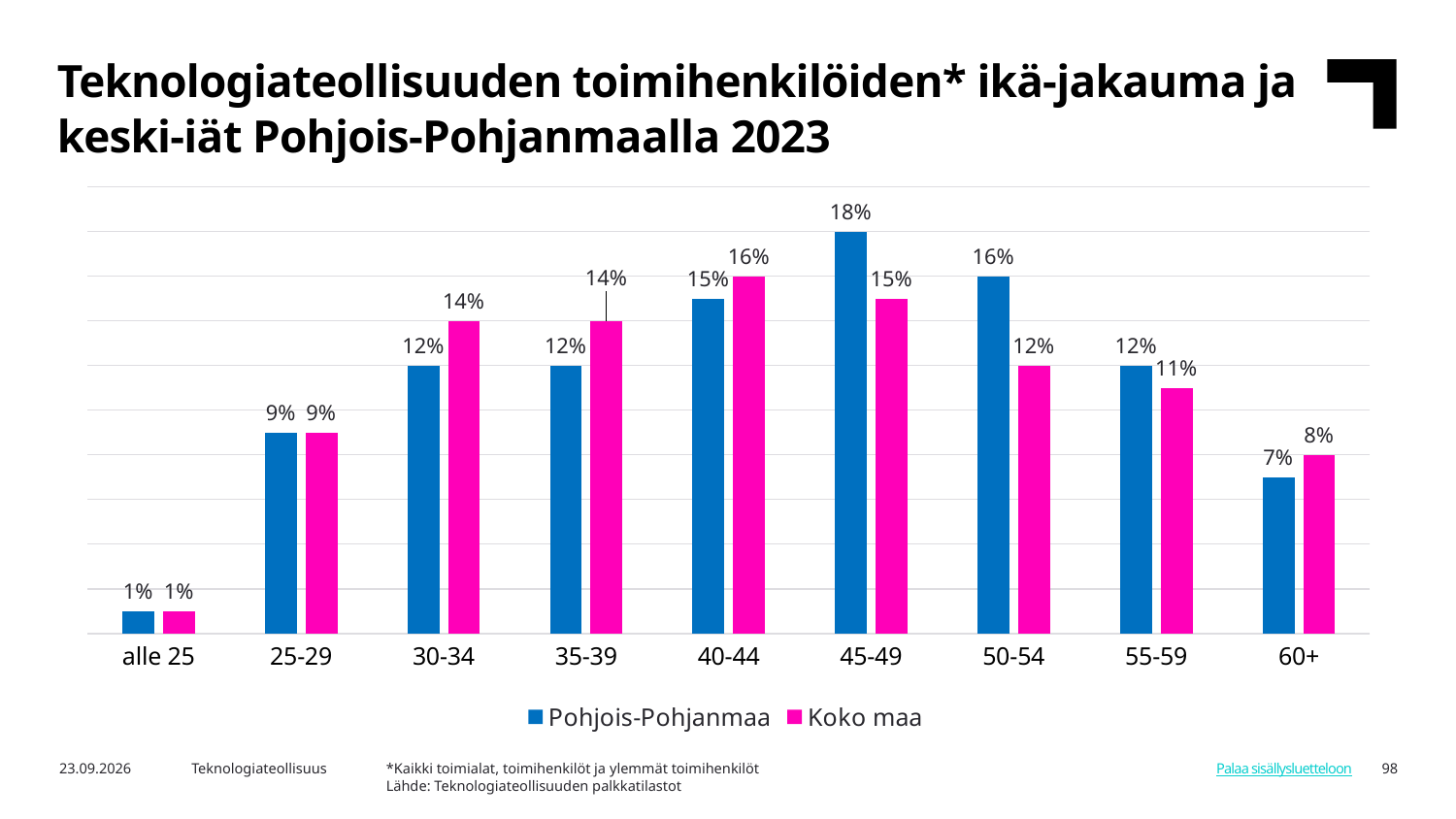
Which age group has the lowest value for Koko maa? alle 25 Which colour represents the Koko maa series? Pink What is the value for Koko maa in the 60+ age group? 8% What is the value for Pohjois-Pohjanmaa in the 45-49 age group? 18% Which age group has the highest value for Pohjois-Pohjanmaa? 45-49 How many age groups are shown on the x axis? 9 Do the Pohjois-Pohjanmaa values rise or fall from the 45-49 age group to the 60+ age group? Fall In the 35-39 age group, which series has the larger value, Pohjois-Pohjanmaa or Koko maa? Koko maa How many series does the legend list? 2 What is the difference between Pohjois-Pohjanmaa and Koko maa in the 50-54 age group? 4 percentage points What is the value for Koko maa in the 30-34 age group? 14% What kind of chart is shown on the slide? Bar chart